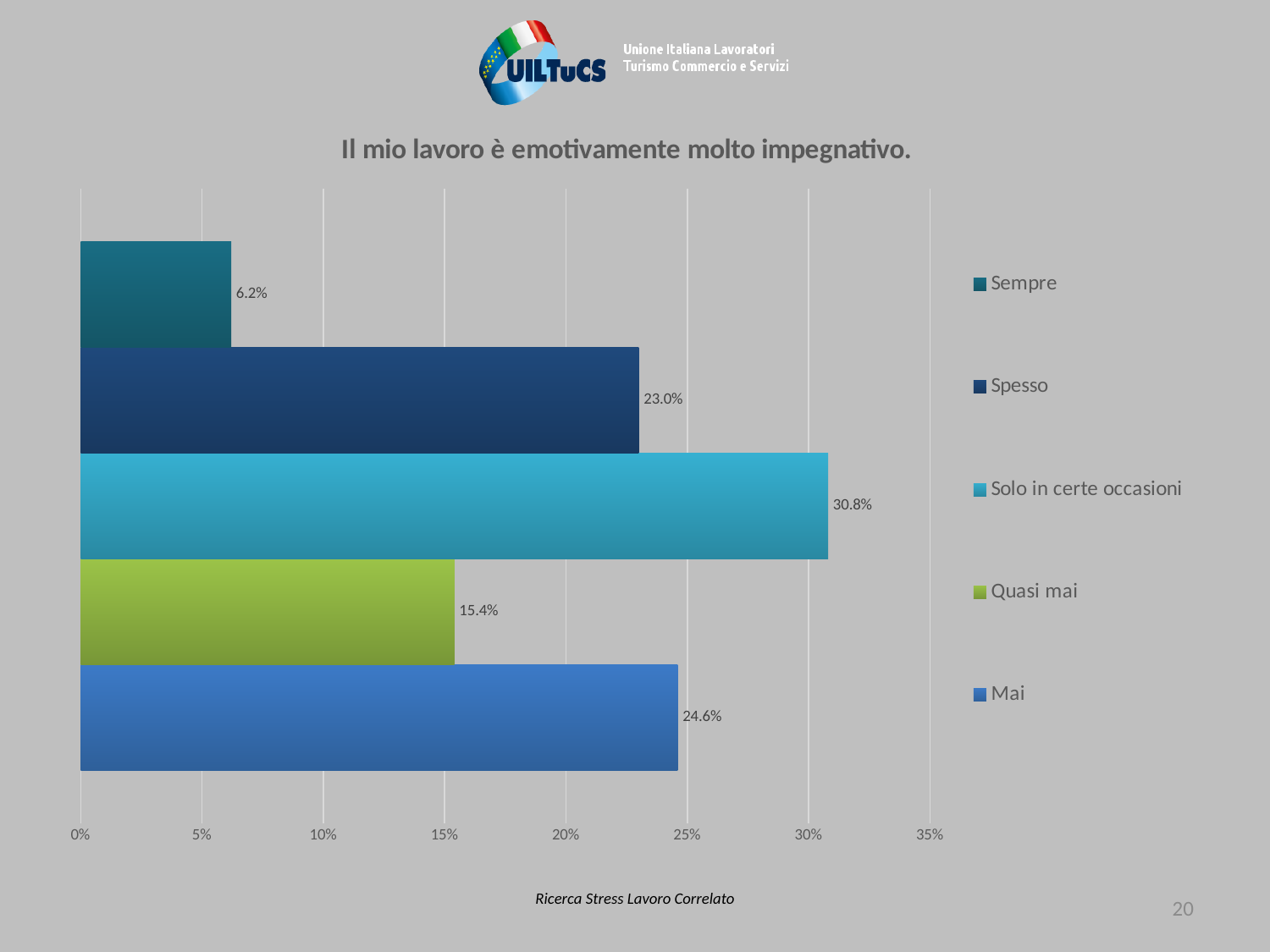
What is the value for Solo in certe occasioni? 30.8% How many categories does the legend list? 5 Which is larger, the value for Quasi mai or the value for Spesso? Spesso What is the value for Quasi mai? 15.4% What is the value for Sempre? 6.2% What kind of chart is shown on the slide? Bar chart What is the difference between the values for Mai and Spesso? 1.6% Which category has the lowest value? Sempre What is the title of the chart? Il mio lavoro è emotivamente molto impegnativo. What is the value for Spesso? 23.0% What is the value for Mai? 24.6% Which category has the highest value? Solo in certe occasioni